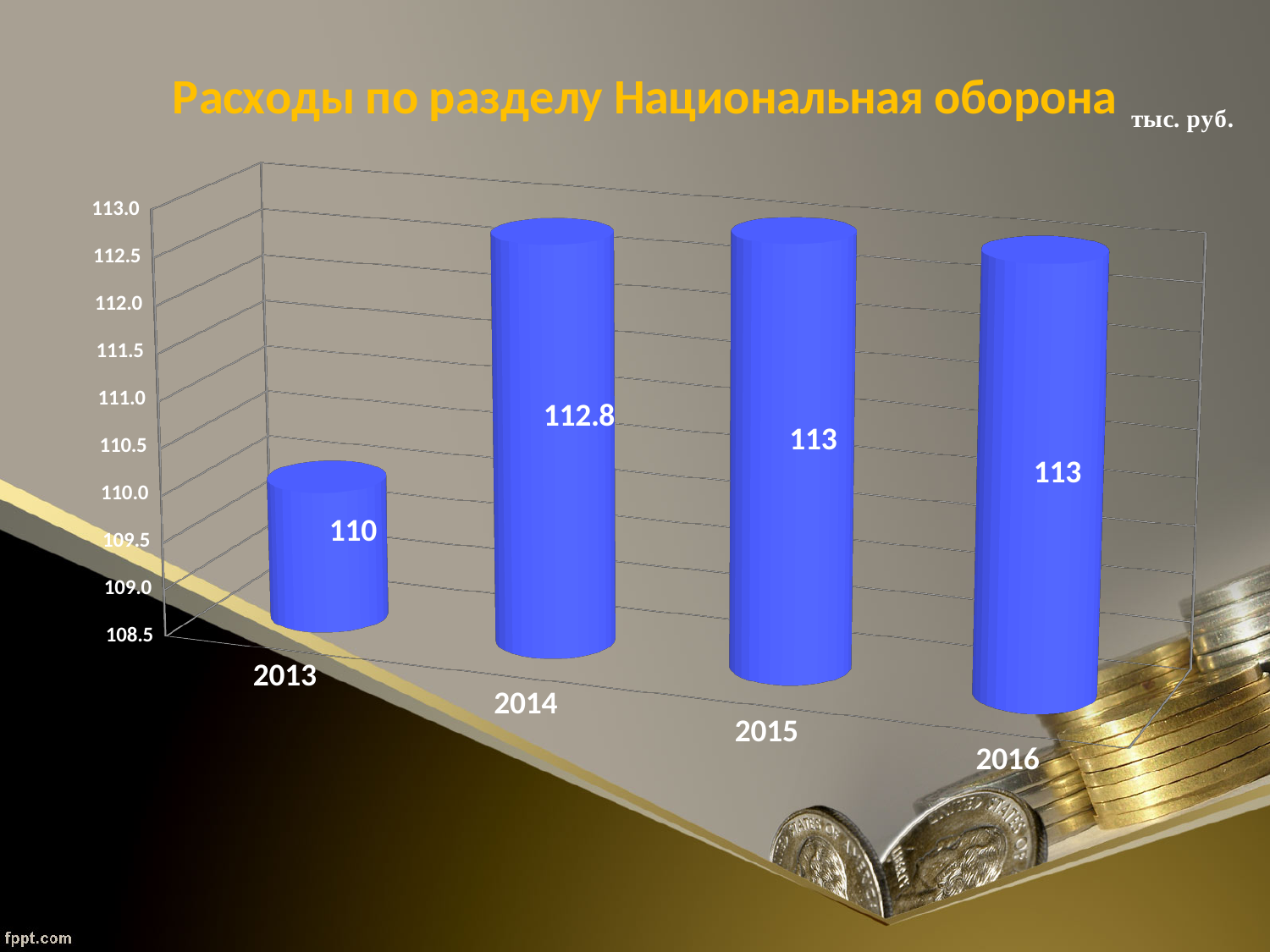
How many years are shown on the chart? 4 Which year has the lowest value? 2013 What kind of chart is shown on the slide? bar chart What is the difference between the values for 2015 and 2013? 3 What is the difference between the values for 2014 and 2013? 2.8 What is the value for 2013? 110 Which is larger, the value for 2014 or the value for 2013? 2014 What is the value for 2014? 112.8 Is the value for 2013 greater or less than 111.0? less Do the values generally rise or fall from 2013 to 2016? rise What is the value for 2015? 113 What is the value for 2016? 113